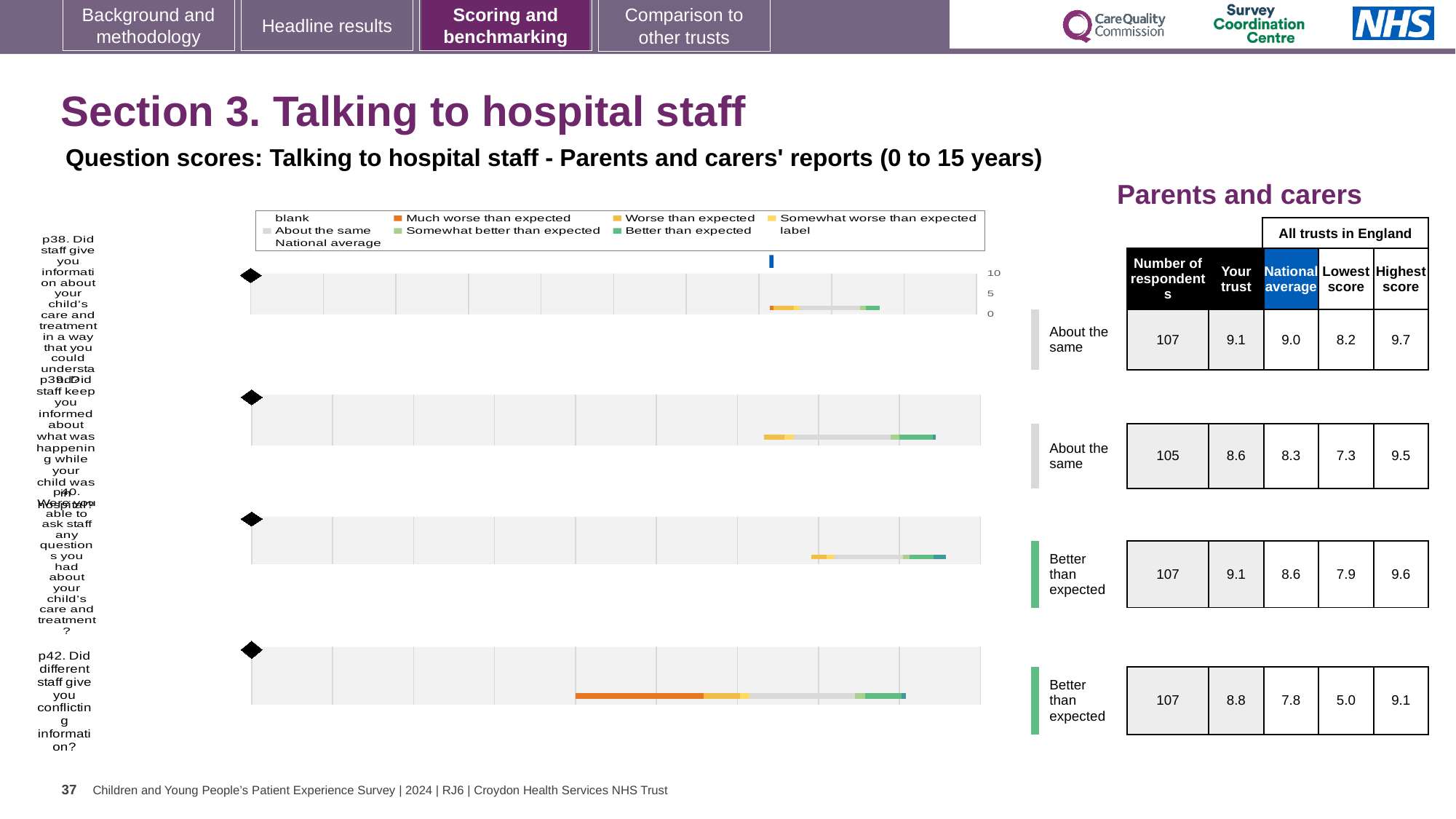
For the p39 chart (staff keeping you informed about what was happening), what is the national average score shown in the table? 8.3 For the p38 chart (staff giving information about your child's care in a way you could understand), what is the 'Your trust' score shown in the table? 9.1 For the p42 chart (different staff giving conflicting information), what is the lowest score among all trusts in England? 5.0 Is the 'Your trust' score for the p40 chart larger or smaller than the national average? larger What is the difference between the 'Your trust' score and the national average for the p42 chart? 1.0 In the legend above the charts, what colour represents 'Better than expected'? green How many respondents answered question p39 according to the table? 105 What kind of chart is used to show the benchmarking results for each question on this slide? bar chart In the legend above the charts, what colour represents 'Much worse than expected'? orange Which of the four questions has the lowest 'Your trust' score in the table? p39 How many question charts (p38, p39, p40, p42) are shown on the slide? 4 For the p40 chart (being able to ask staff questions), what is the highest score among all trusts in England? 9.6